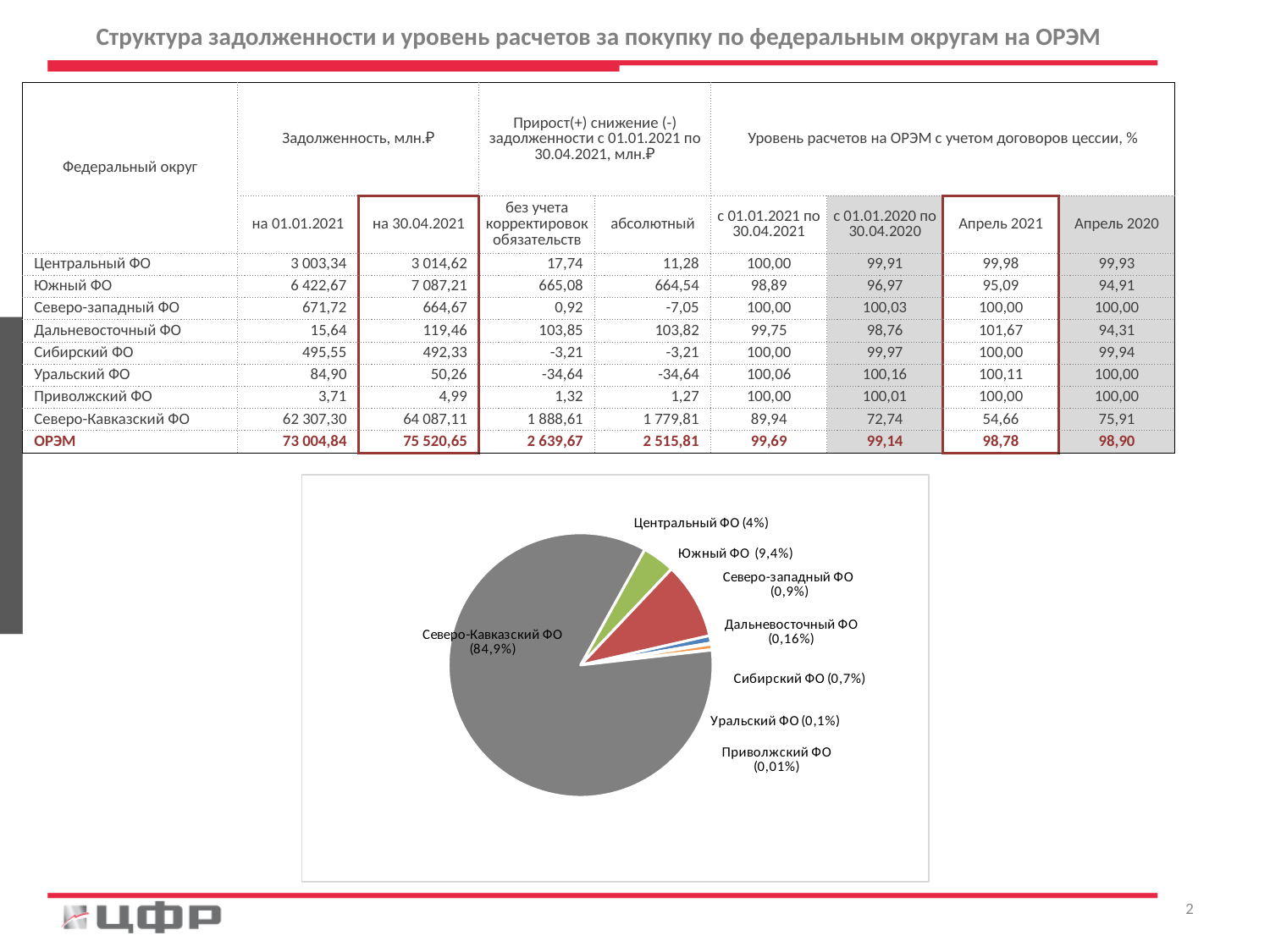
What share of the pie does Северо-Кавказский ФО account for? 84,9% What is the difference in percentage points between the shares of Северо-Кавказский ФО and Южный ФО? 75,5 What share is shown for Дальневосточный ФО in the pie chart? 0,16% Which federal district has the smallest share in the pie chart? Приволжский ФО What kind of chart is shown on the slide? pie chart What share of the pie does Южный ФО account for? 9,4% How many slices does the pie chart have? 8 What share is shown for Центральный ФО in the pie chart? 4% Which federal district has the largest slice in the pie chart? Северо-Кавказский ФО Which has the larger share in the pie chart, Южный ФО or Центральный ФО? Южный ФО What colour is the largest slice of the pie chart? grey What share is shown for Уральский ФО in the pie chart? 0,1%